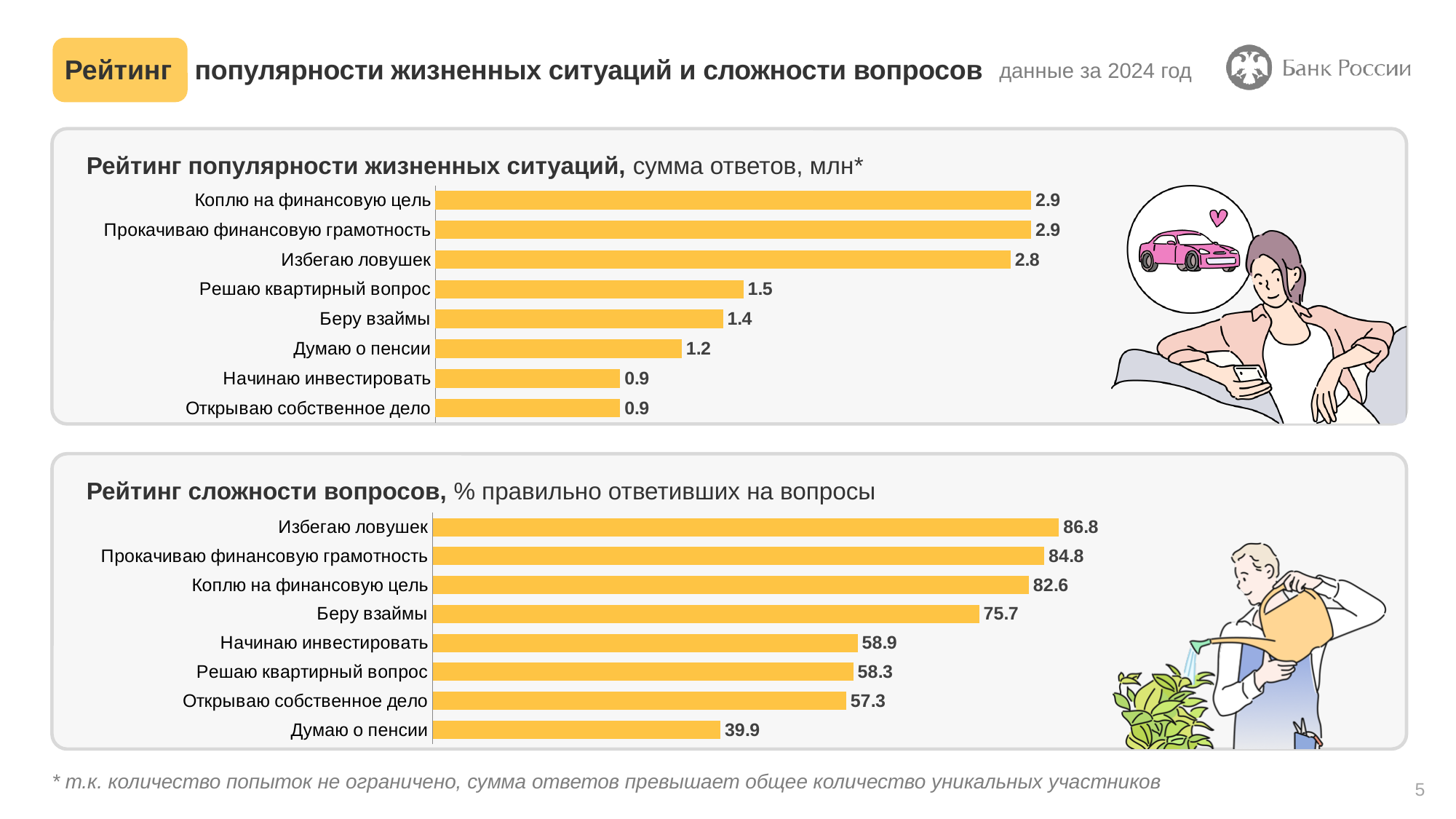
In the chart 'Рейтинг сложности вопросов', which category has the lowest value? Думаю о пенсии In the chart 'Рейтинг популярности жизненных ситуаций', what is the difference between 'Избегаю ловушек' and 'Беру взаймы'? 1.4 In the chart 'Рейтинг сложности вопросов', what is the value for 'Открываю собственное дело'? 57.3 In the chart 'Рейтинг популярности жизненных ситуаций', what is the value for 'Решаю квартирный вопрос'? 1.5 What unit is stated in the title of the top chart 'Рейтинг популярности жизненных ситуаций'? сумма ответов, млн In the chart 'Рейтинг популярности жизненных ситуаций', how many categories are shown? 8 In the chart 'Рейтинг популярности жизненных ситуаций', what is the value for 'Думаю о пенсии'? 1.2 In the chart 'Рейтинг сложности вопросов', what is the difference between 'Избегаю ловушек' and 'Думаю о пенсии'? 46.9 What type of chart is 'Рейтинг сложности вопросов'? Bar chart In the chart 'Рейтинг популярности жизненных ситуаций', which is larger: 'Беру взаймы' or 'Начинаю инвестировать'? Беру взаймы In the chart 'Рейтинг сложности вопросов', which category has the highest value? Избегаю ловушек In the chart 'Рейтинг сложности вопросов', what is the value for 'Беру взаймы'? 75.7